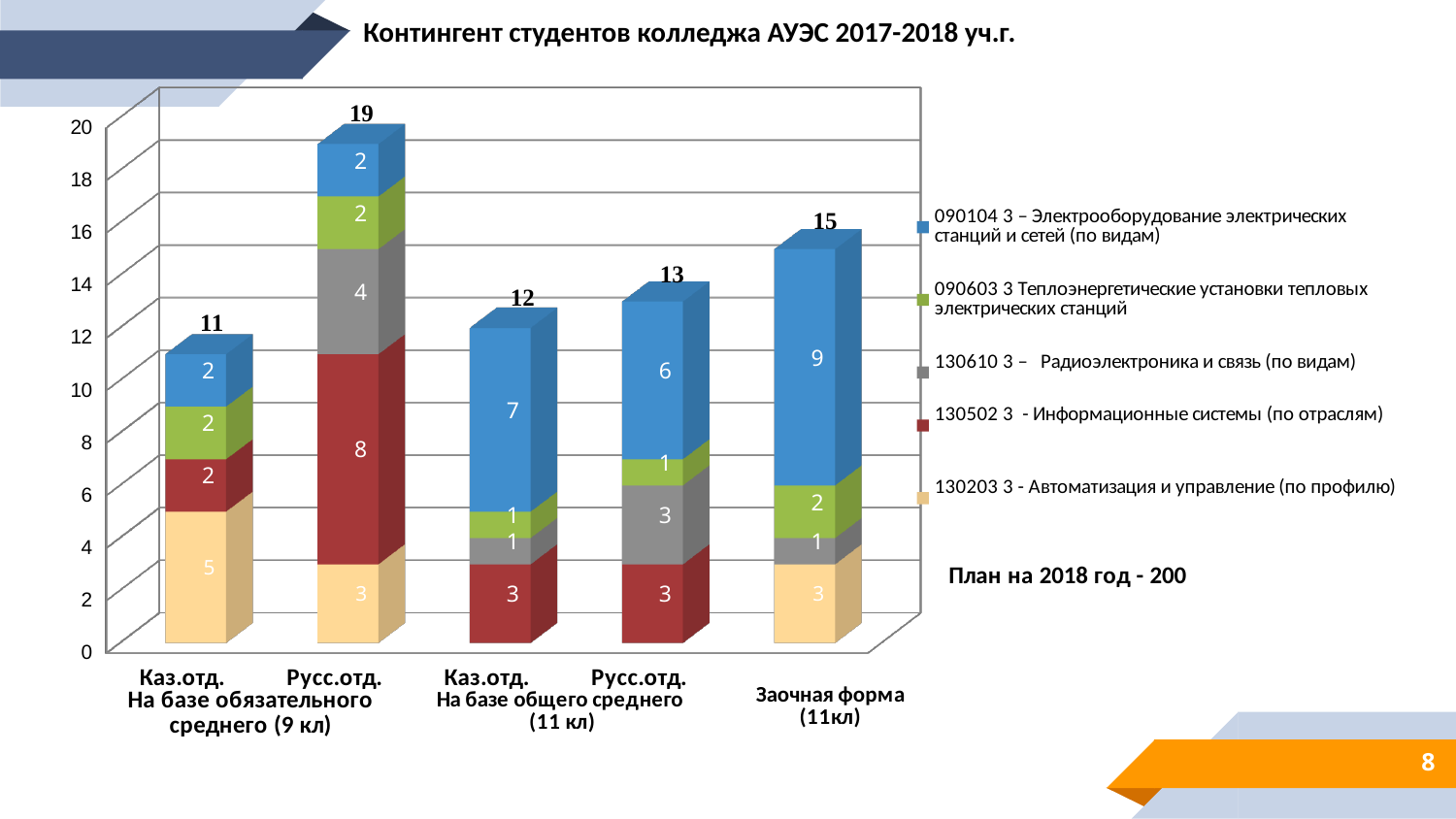
How many series does the legend list? 5 What is the value of the 130203 3 - Автоматизация и управление segment in the Каз.отд. (9 кл) bar? 5 What is the title of the chart? Контингент студентов колледжа АУЭС 2017-2018 уч.г. Which is larger: the total for Русс.отд. (11 кл) or the total for Каз.отд. (11 кл)? Русс.отд. (11 кл) What is the difference between the totals of the Заочная форма (11кл) bar and the Каз.отд. (11 кл) bar? 3 Which category has the lowest total? Каз.отд. (На базе обязательного среднего, 9 кл) What is the value of the 090104 3 – Электрооборудование электрических станций и сетей segment in the Заочная форма (11кл) bar? 9 What is the total for the Русс.отд. (На базе обязательного среднего, 9 кл) bar? 19 What type of chart is shown on the slide? Stacked bar chart How many categories are shown on the x axis? 5 What is the value of the 130502 3 - Информационные системы segment in the Русс.отд. (9 кл) bar? 8 Which category has the highest total? Русс.отд. (На базе обязательного среднего, 9 кл)